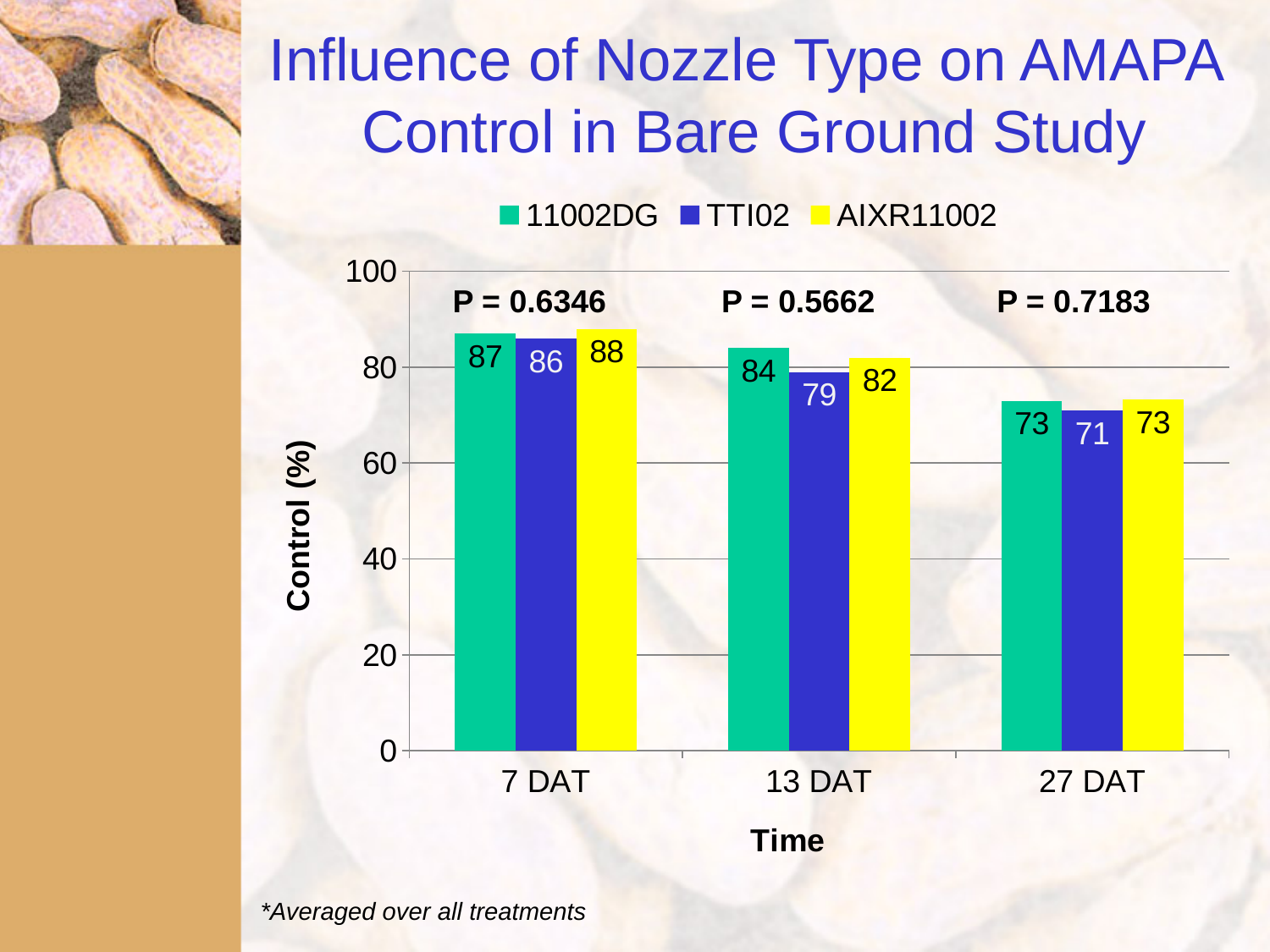
What is the control (%) for AIXR11002 at 27 DAT? 73 What kind of chart is shown on the slide? bar chart Which is larger, the control for 11002DG at 7 DAT or at 27 DAT? 7 DAT Which nozzle type has the highest control at 7 DAT? AIXR11002 Does the control for 11002DG rise or fall from 7 DAT to 27 DAT? fall Is the control for TTI02 at 27 DAT greater or less than 80? less How many time points are shown on the x axis? 3 What is the control (%) for TTI02 at 13 DAT? 79 What is the difference in control (%) between 11002DG and TTI02 at 13 DAT? 5 How many series does the legend list? 3 What is the control (%) for 11002DG at 7 DAT? 87 Which nozzle type has the lowest control at 13 DAT? TTI02